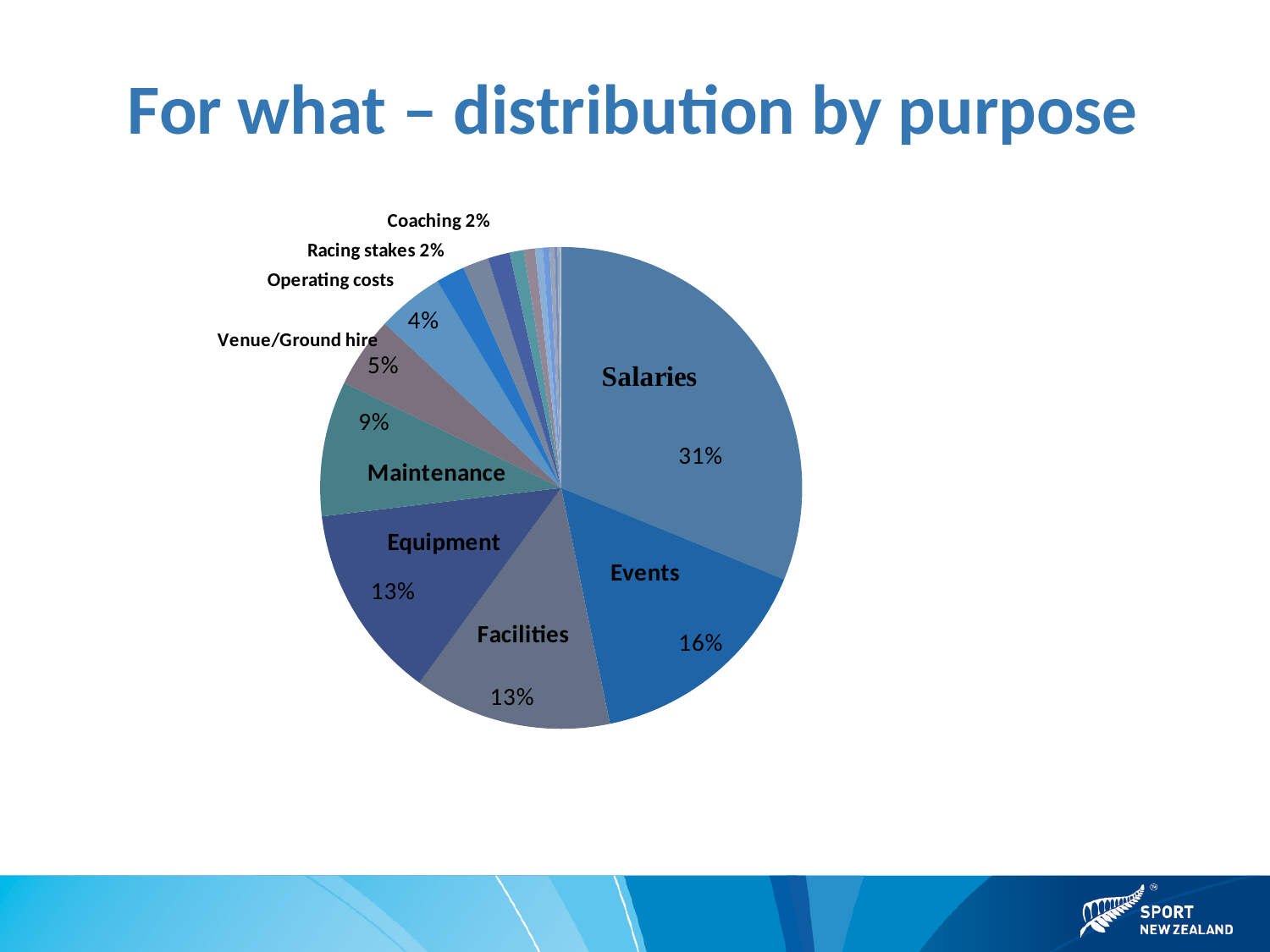
Which purpose has the largest share of the pie? Salaries What kind of chart is shown on the slide? Pie chart What percentage is shown for Venue/Ground hire? 5% What percentage is shown for Events? 16% What percentage is shown for Coaching? 2% What percentage is shown for Operating costs? 4% What is the combined share of Facilities and Equipment? 26% What percentage is shown for Maintenance? 9% How many percentage points larger is the Salaries share than the Events share? 15 What share of the pie does Salaries account for? 31% What is the title of the slide? For what – distribution by purpose Which has the larger share, Events or Maintenance? Events